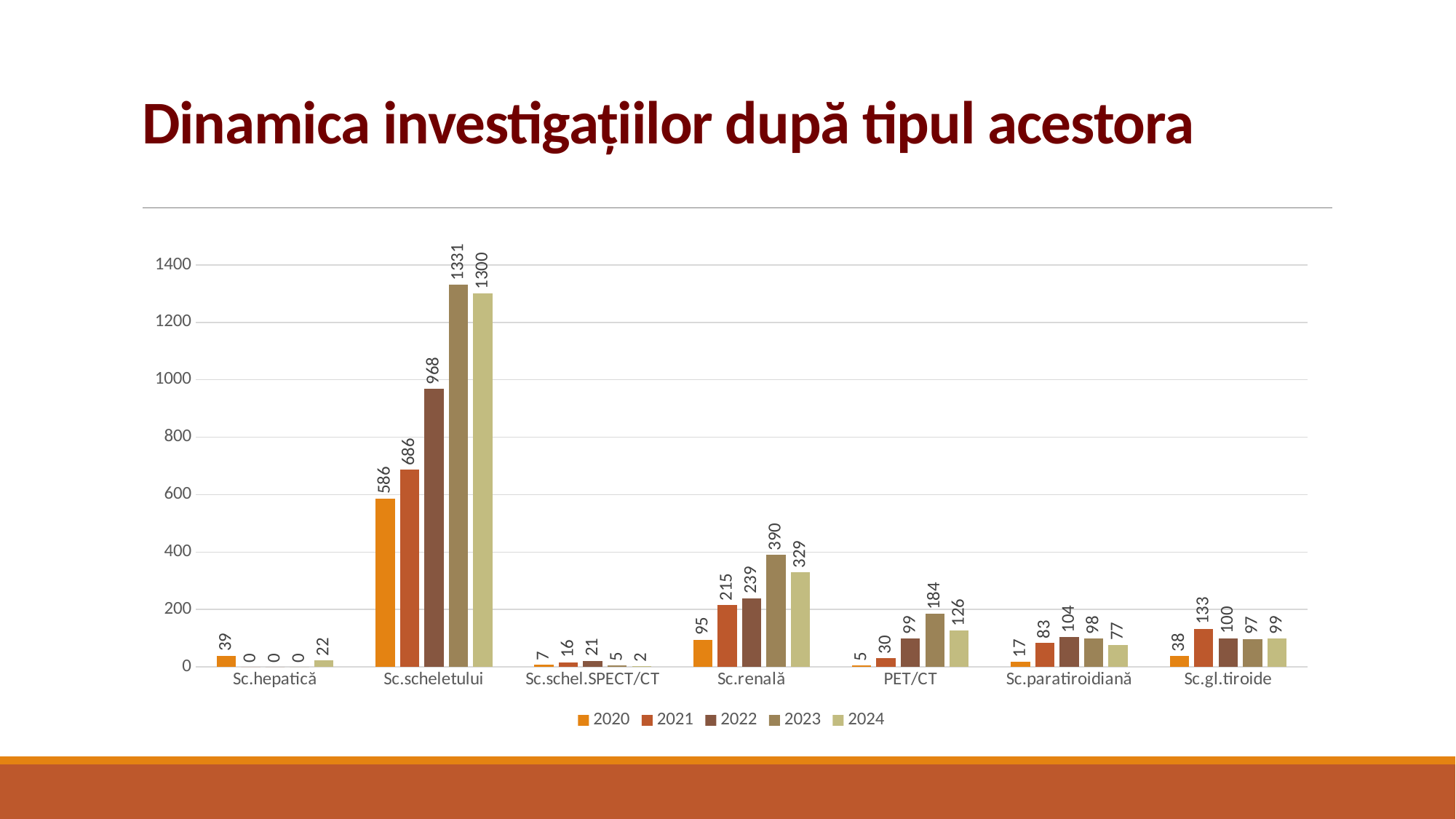
Which year has the lowest value for Sc.gl.tiroide? 2020 Is the 2022 value for Sc.scheletului greater or less than 1000? less How many categories are shown on the x axis? 7 What is the value for Sc.scheletului in 2023? 1331 How many series does the legend list? 5 What is the difference between the 2023 and 2024 values for Sc.scheletului? 31 Which is larger: the 2023 value for Sc.renală or the 2023 value for PET/CT? Sc.renală What is the title of the slide? Dinamica investigațiilor după tipul acestora Which category has the highest value in 2024? Sc.scheletului What is the value for PET/CT in 2024? 126 What is the value for Sc.renală in 2022? 239 What kind of chart is shown on the slide? bar chart